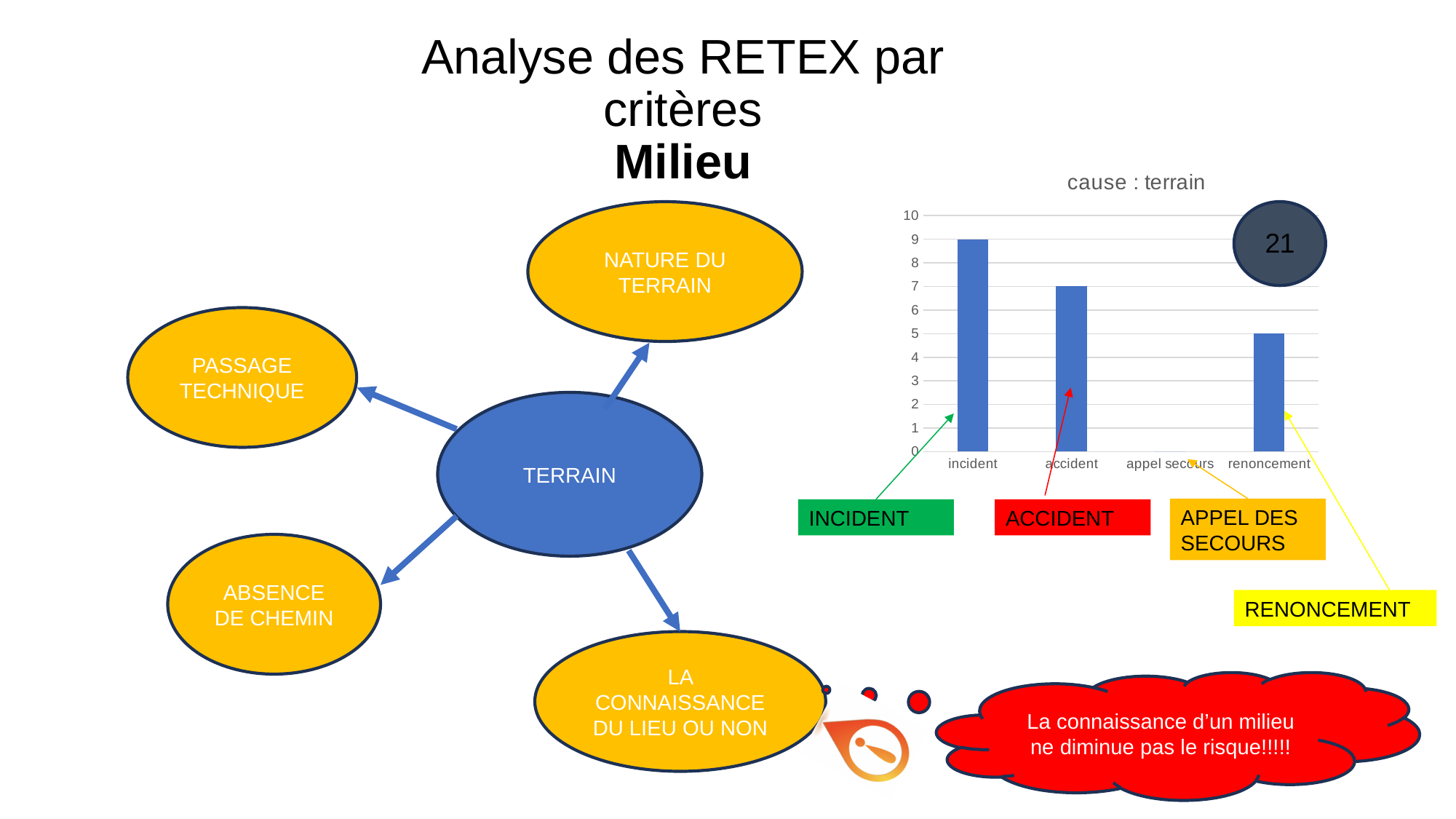
What is the value for renoncement in the chart? 5 What is the title of the chart on the slide? cause : terrain What is the value for accident in the chart? 7 Which is larger, the value for accident or the value for renoncement? accident What is the value for incident in the chart? 9 Which category has the highest value in the chart? incident Is the value for renoncement greater or less than 6? less What kind of chart is shown on the slide? bar chart What is the value for appel secours in the chart? 0 What is the difference between the values for incident and accident? 2 How many categories are shown on the x axis of the chart? 4 Which category has the lowest value in the chart? appel secours